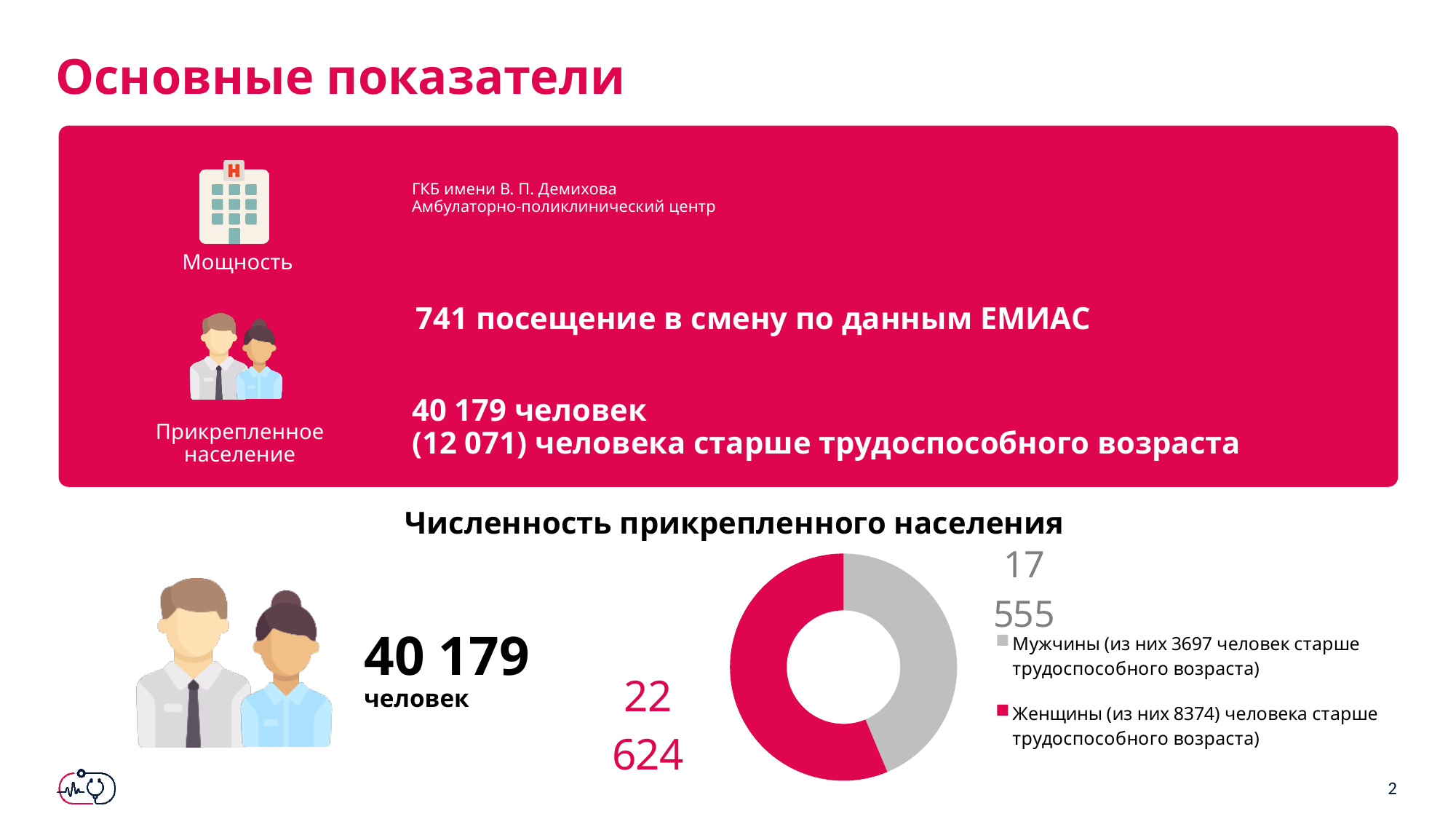
What is the total of the two slices in the chart 'Численность прикрепленного населения'? 40 179 What is the value for Мужчины in the chart 'Численность прикрепленного населения'? 17 555 What share of the total does the Женщины slice represent in the chart 'Численность прикрепленного населения', to the nearest percent? 56% What is the difference between the values for Женщины and Мужчины in the chart 'Численность прикрепленного населения'? 5 069 What is the value for Женщины in the chart 'Численность прикрепленного населения'? 22 624 How many categories are shown in the chart 'Численность прикрепленного населения'? 2 What colour is the Женщины slice in the chart 'Численность прикрепленного населения'? Red (pink) Which category has the largest slice in the chart 'Численность прикрепленного населения'? Женщины In the chart 'Численность прикрепленного населения', is the value for Мужчины larger or smaller than the value for Женщины? smaller Which category has the smallest slice in the chart 'Численность прикрепленного населения'? Мужчины How many entries does the legend of the chart 'Численность прикрепленного населения' list? 2 What kind of chart is 'Численность прикрепленного населения'? Pie (donut) chart